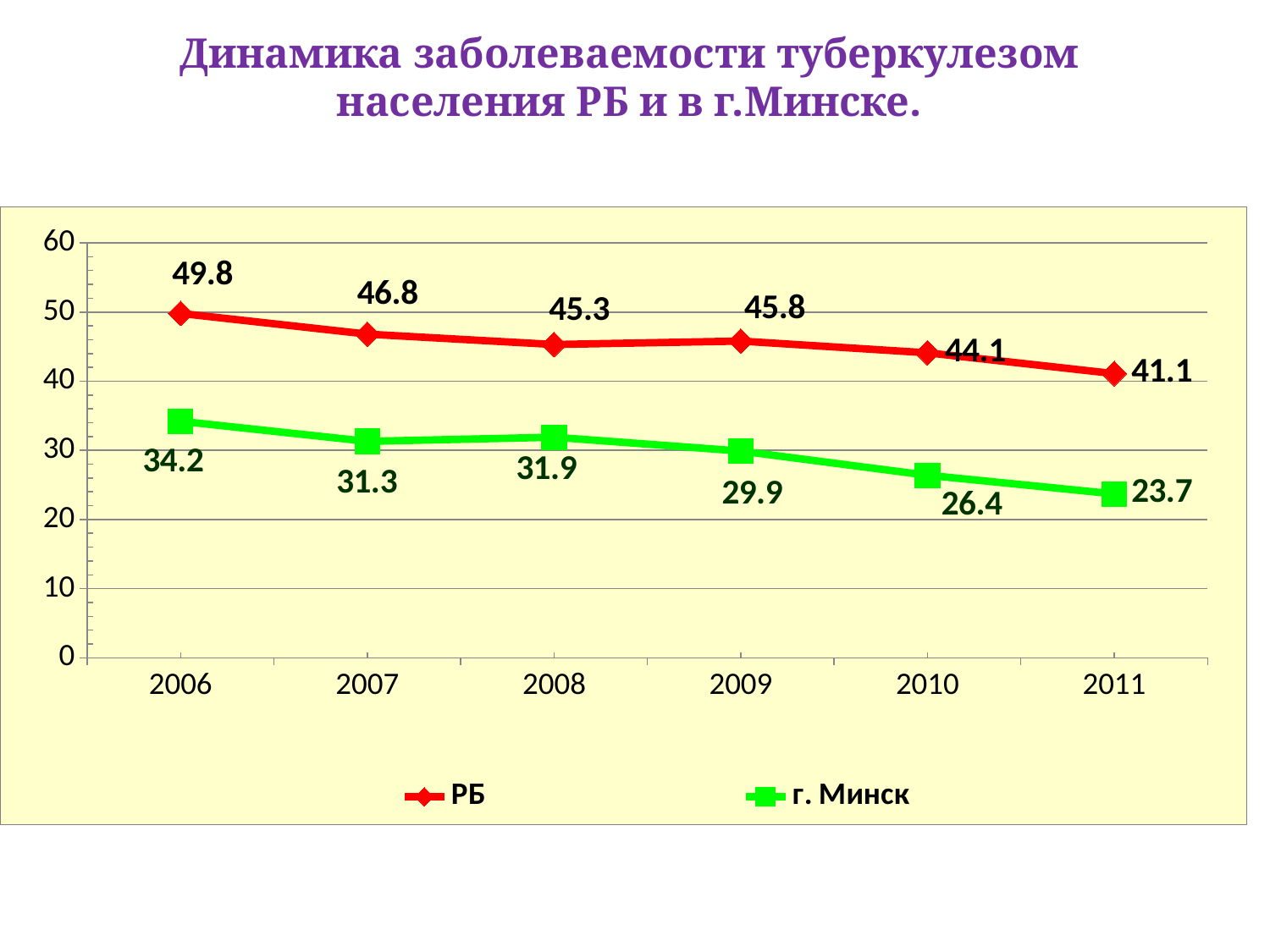
In which year is the РБ series highest? 2006 Do the values for РБ generally rise or fall from 2006 to 2011? fall In which year is the г. Минск series lowest? 2011 What is the value for РБ in 2006? 49.8 What is the value for РБ in 2011? 41.1 What is the value for г. Минск in 2009? 29.9 What colour is the line for г. Минск? green How many years are shown on the x axis? 6 Which is larger in 2008: the value for РБ or for г. Минск? РБ What is the difference between the РБ and г. Минск values in 2010? 17.7 What kind of chart is shown on the slide? line chart How many series does the legend list? 2